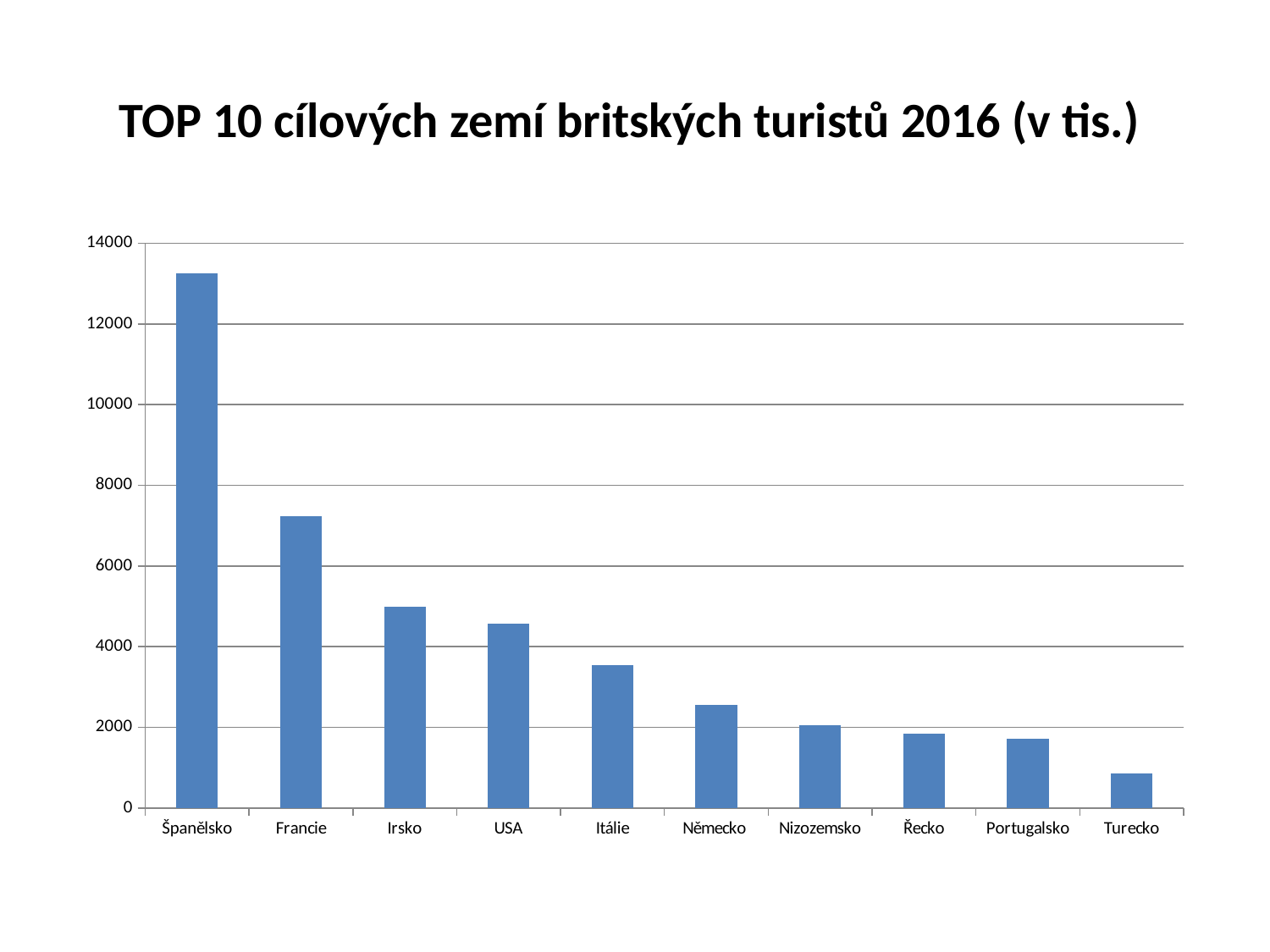
Which has a larger value, Portugalsko or Turecko? Portugalsko Which country has the lowest value in the chart? Turecko What is the title of the chart? TOP 10 cílových zemí britských turistů 2016 (v tis.) Which has a larger value, Irsko or USA? Irsko What kind of chart is shown on the slide? bar chart Is the value for Itálie greater or less than 4000? less Do the values rise or fall from left to right along the x axis? fall Is the value for Francie greater or less than 8000? less Which country has the highest value in the chart? Španělsko How many countries are shown in the chart? 10 Is the value for Turecko greater or less than 2000? less